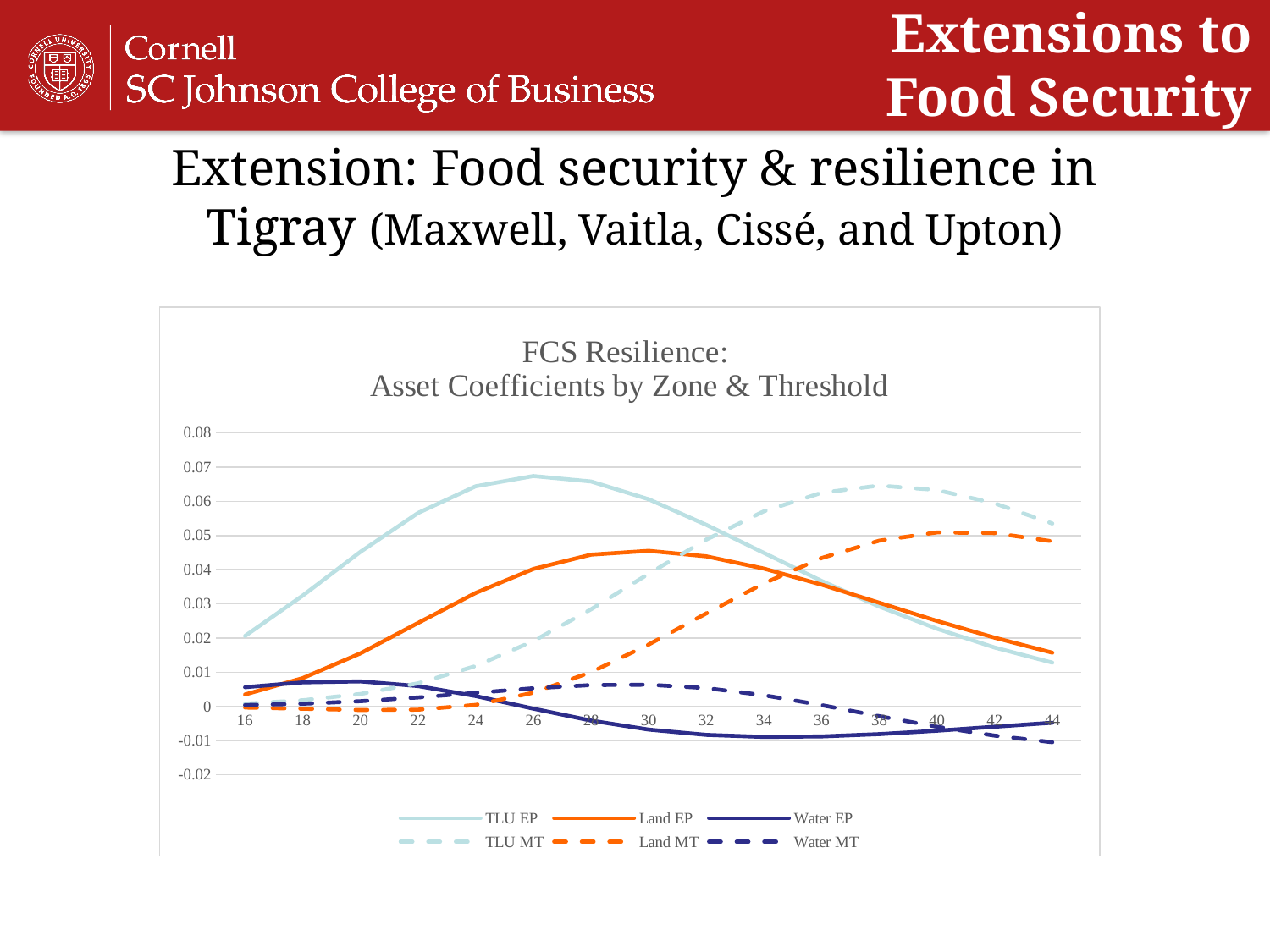
What kind of chart is shown on the slide? line chart What is the title of the chart? FCS Resilience: Asset Coefficients by Zone & Threshold At 40 on the x axis, which series has the larger value, TLU MT or Land MT? TLU MT Is the value of Land EP at 30 greater or less than 0.04? greater Does the TLU MT line rise or fall between 16 and 38 on the x axis? rise Is the value of TLU EP at 26 greater or less than 0.06? greater How many series does the chart's legend list? 6 Is the value of Land MT at 16 greater or less than 0.01? less Does the TLU EP line rise or fall between 26 and 44 on the x axis? fall At 20 on the x axis, which series has the larger value, TLU EP or Land EP? TLU EP How many tick labels are shown on the x axis of the chart? 15